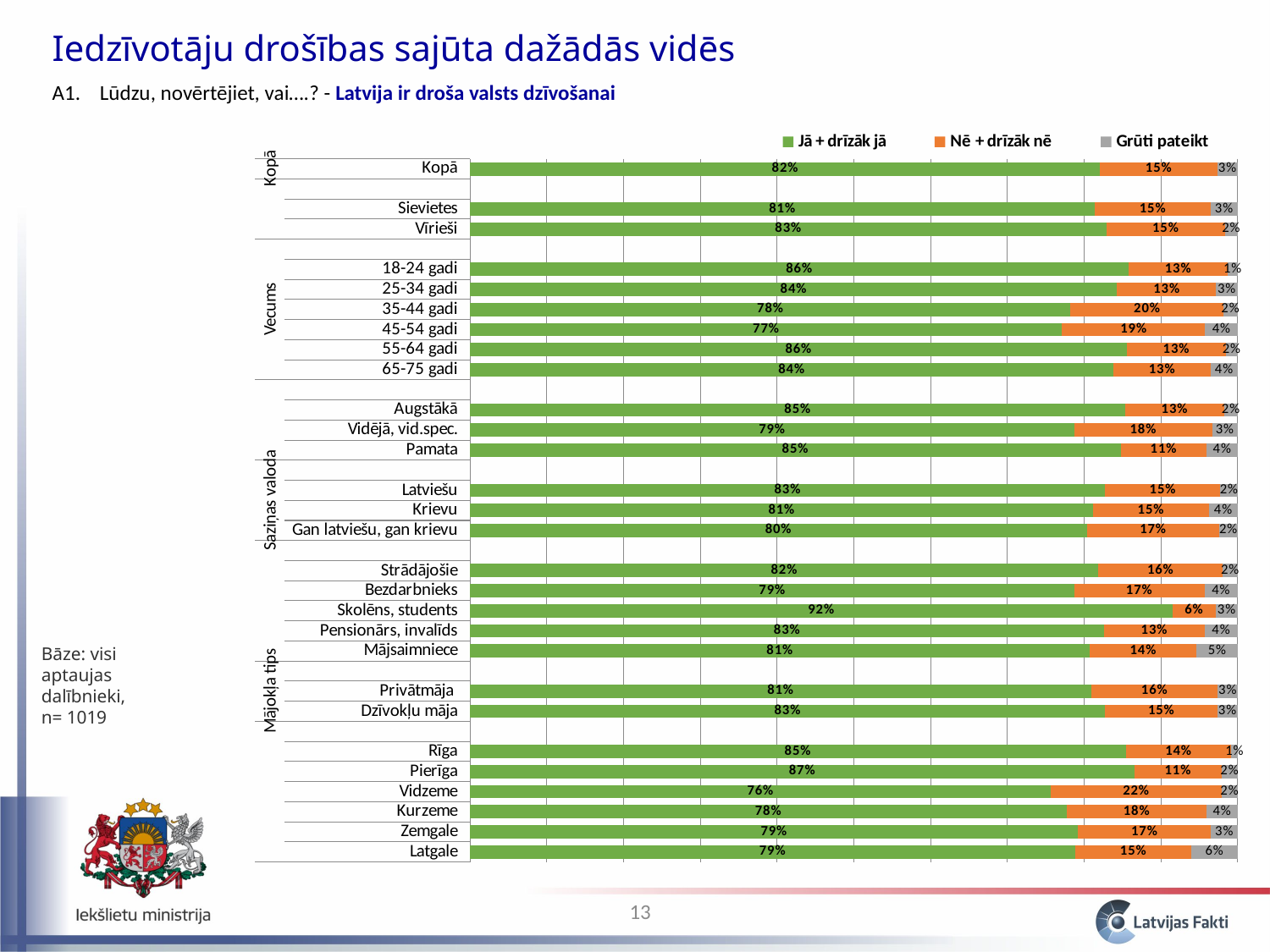
What kind of chart is shown on the slide? Stacked bar chart Which series is shown in green in the legend? Jā + drīzāk jā What is the total of the stacked bar for Mājsaimniece? 100% What is the "Nē + drīzāk nē" value for Skolēns, students? 6% What is the "Grūti pateikt" value for Latgale? 6% What is the difference between the "Jā + drīzāk jā" values for Pierīga and Vidzeme? 11% What is the "Nē + drīzāk nē" value for Vidzeme? 22% What is the "Jā + drīzāk jā" value for Kopā? 82% Which category has the highest "Jā + drīzāk jā" value? Skolēns, students Which category has the lowest "Jā + drīzāk jā" value? Vidzeme Which has a larger "Nē + drīzāk nē" value, 35-44 gadi or 18-24 gadi? 35-44 gadi How many series does the legend list? 3